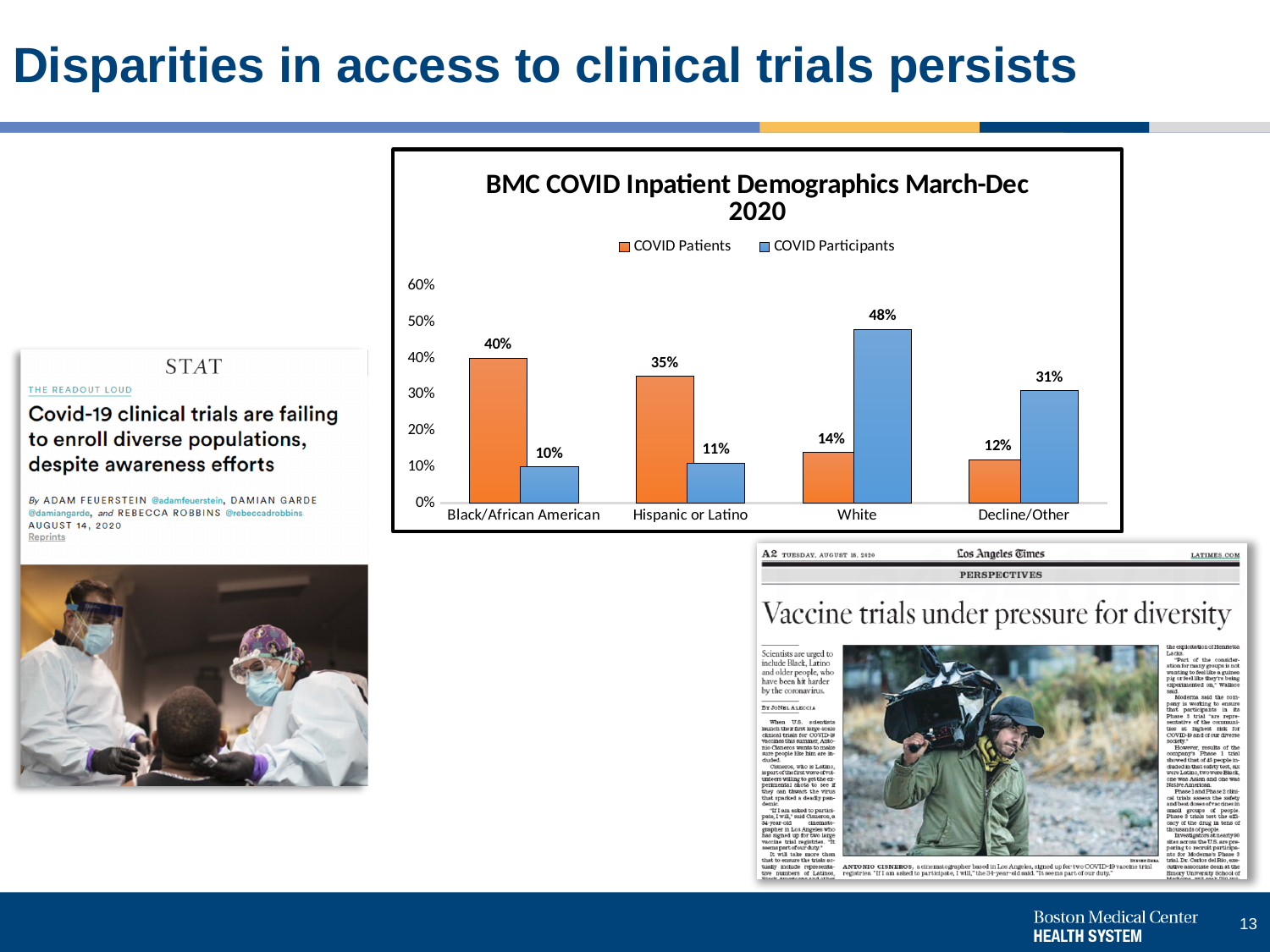
Which category has the lowest COVID Patients value? Decline/Other What is the COVID Participants value for White? 48% Which category has the highest COVID Participants value? White How many series does the legend list? 2 Which is larger for White: COVID Patients or COVID Participants? COVID Participants What kind of chart is shown? Bar chart What is the COVID Patients value for Black/African American? 40% What is the title of the chart? BMC COVID Inpatient Demographics March-Dec 2020 What is the COVID Participants value for Hispanic or Latino? 11% How many categories are shown on the x axis? 4 What is the difference between the COVID Patients and COVID Participants values for Black/African American? 30% What is the COVID Patients value for Decline/Other? 12%